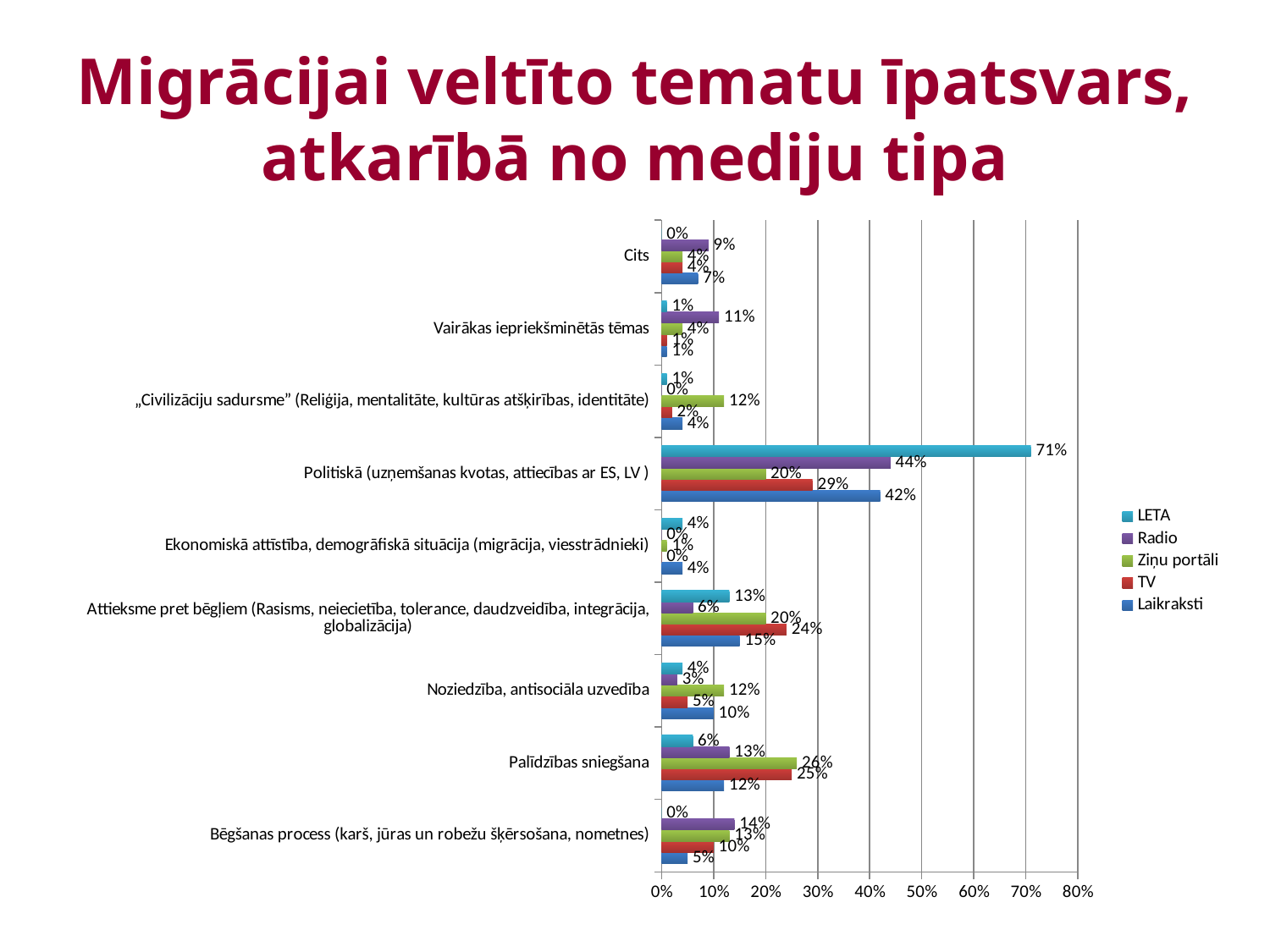
For the category "Bēgšanas process", which is larger: the Radio value or the Laikraksti value? Radio Which category has the highest LETA value? Politiskā (uzņemšanas kvotas, attiecības ar ES, LV ) For the category "Politiskā", what is the difference between the LETA value and the Radio value? 27 percentage points What is the Radio value for the category "Vairākas iepriekšminētās tēmas"? 11% What is the Laikraksti value for the category "Politiskā (uzņemšanas kvotas, attiecības ar ES, LV )"? 42% What kind of chart is shown on the slide? Bar chart How many categories (topics) are shown on the chart? 9 Is the Ziņu portāli value for "Palīdzības sniegšana" greater or less than 20%? greater How many series does the legend list? 5 What is the TV value for the category "Attieksme pret bēgļiem"? 24% What is the LETA value for the category "Politiskā (uzņemšanas kvotas, attiecības ar ES, LV )"? 71% Which category has the lowest Laikraksti value? Vairākas iepriekšminētās tēmas